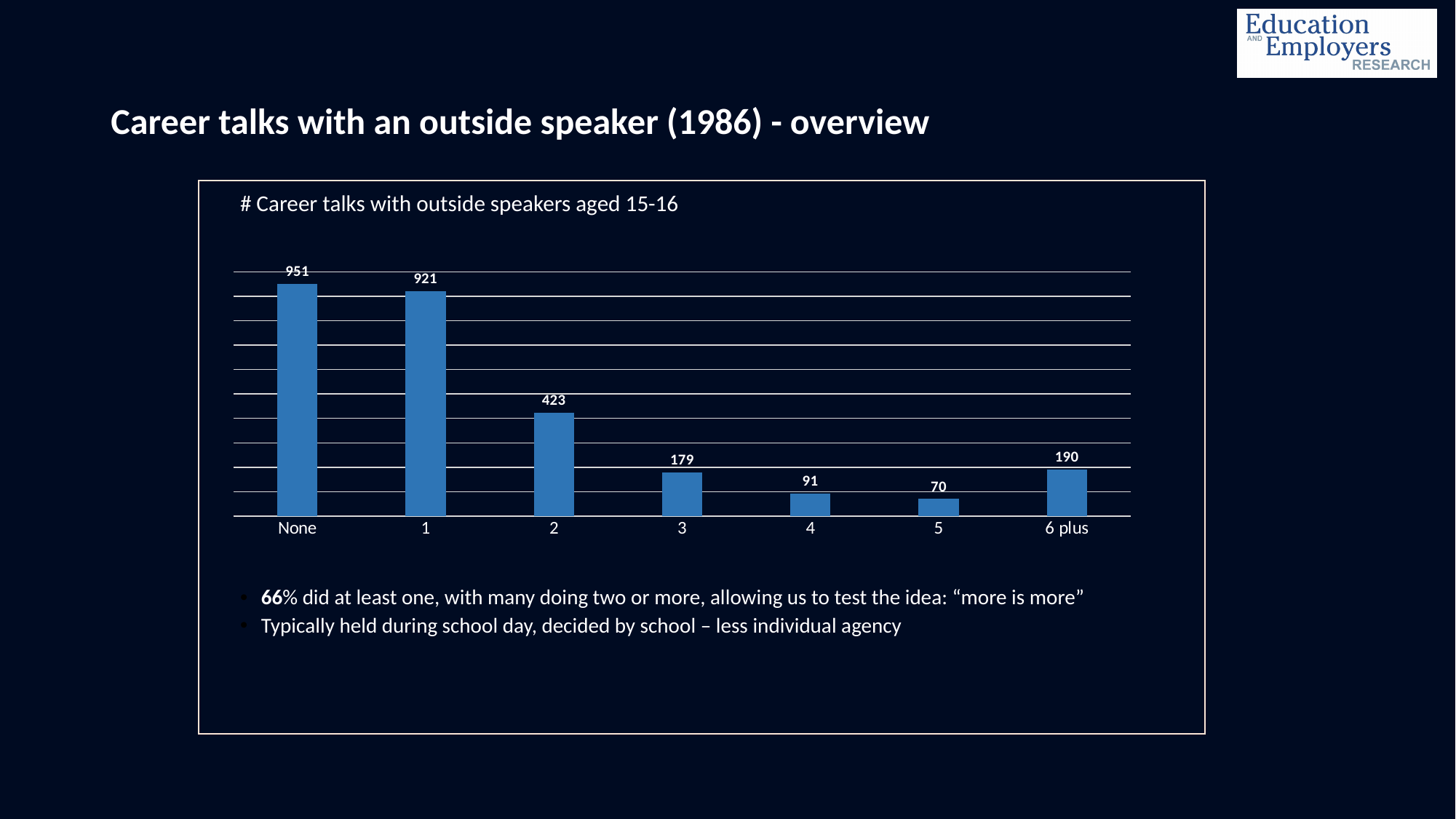
What is the value for the 'None' category? 951 What is the difference between the values for 'None' and '1'? 30 What is the title of the chart? # Career talks with outside speakers aged 15-16 What is the value for the '2' category? 423 Which category has the highest value? None What is the difference between the values for '2' and '3'? 244 Which category has the lowest value? 5 What is the value for the '6 plus' category? 190 Which is larger, the value for '3' or the value for '6 plus'? 6 plus What kind of chart is shown on the slide? Bar chart How many categories are shown on the x axis? 7 What is the value for the '4' category? 91